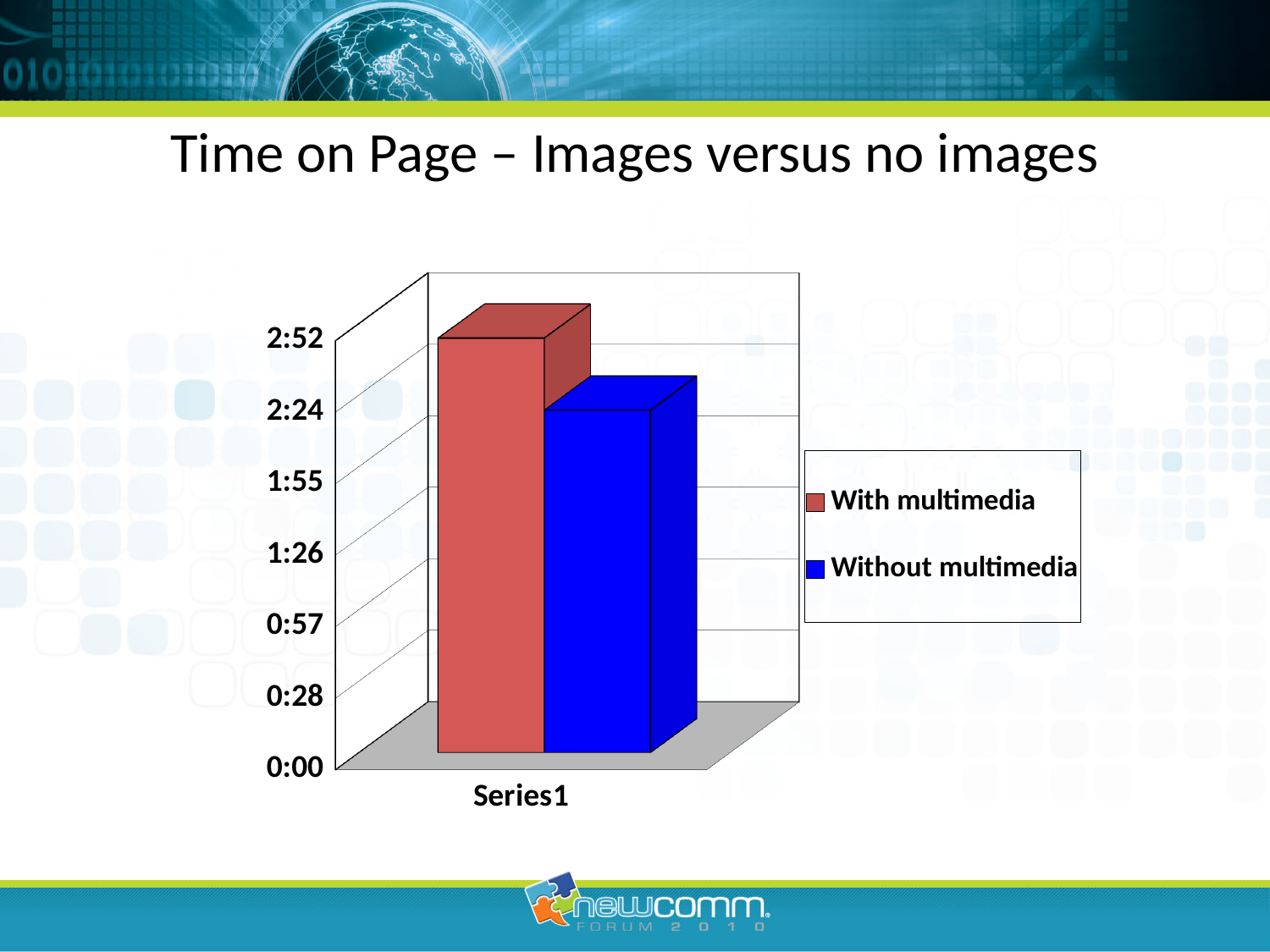
Which series has the shortest bar? Without multimedia How many categories are shown on the x axis? 1 How many series does the legend list? 2 Which series has the tallest bar? With multimedia What colour is the bar for Without multimedia? blue What is the title of the slide containing the chart? Time on Page – Images versus no images Which series has the higher time on page, With multimedia or Without multimedia? With multimedia Is the value for Without multimedia greater or less than 2:52? less Is the value for With multimedia greater or less than 2:24? greater What kind of chart is shown on the slide? bar chart Is the value for Without multimedia greater or less than 1:55? greater